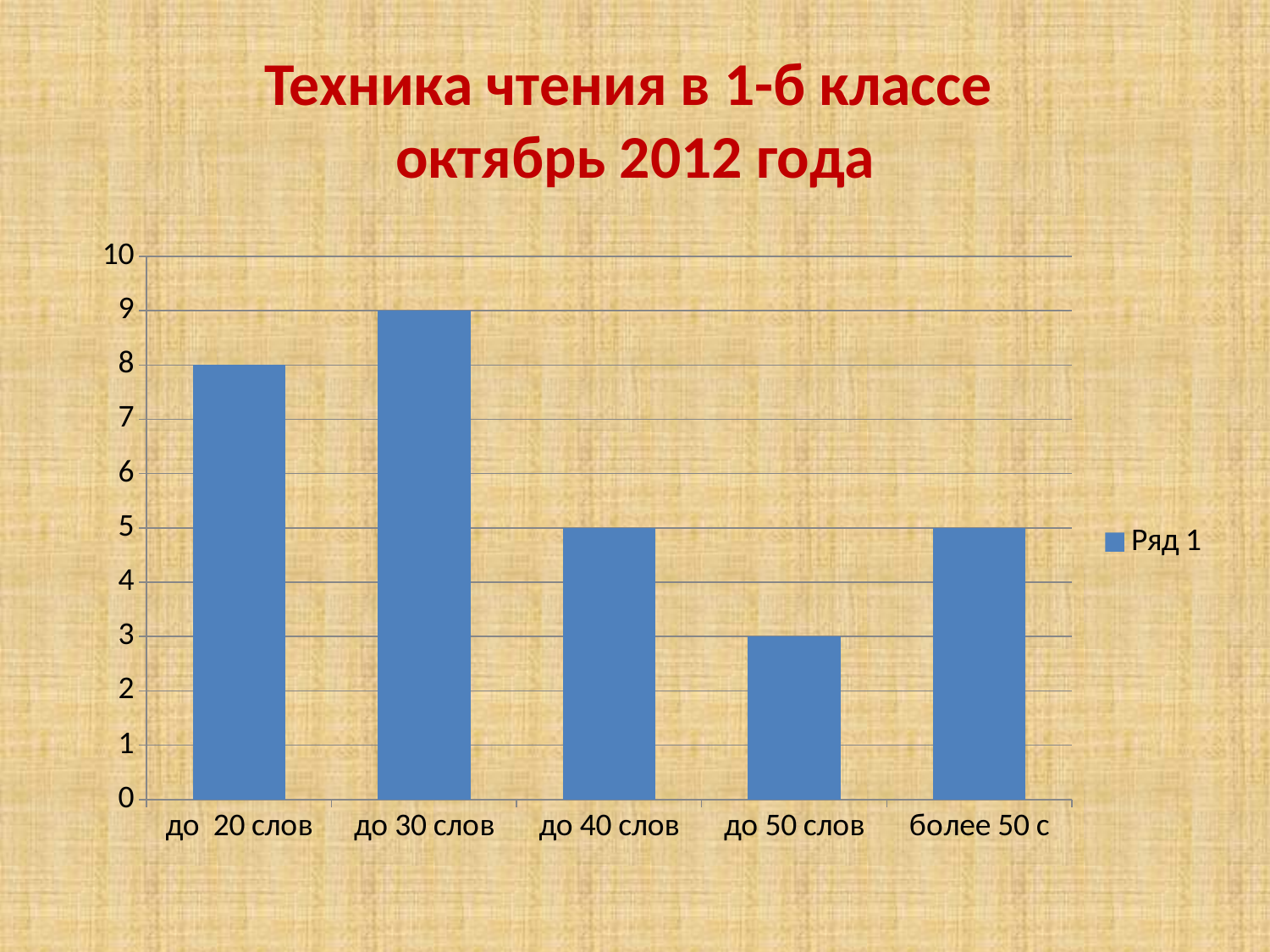
What type of chart is shown on the slide? bar chart What is the difference between the values for "до 30 слов" and "до 50 слов"? 6 How many series does the legend list? 1 What is the value for "до 50 слов"? 3 Which category has the lowest value? до 50 слов What is the name of the series in the legend? Ряд 1 Which category has the highest value? до 30 слов Is the value for "более 50 с" greater or less than 8? less Which is larger, the value for "до 20 слов" or the value for "до 40 слов"? до 20 слов How many categories are shown on the x axis? 5 What is the value for "до 20 слов"? 8 What is the value for "до 30 слов"? 9